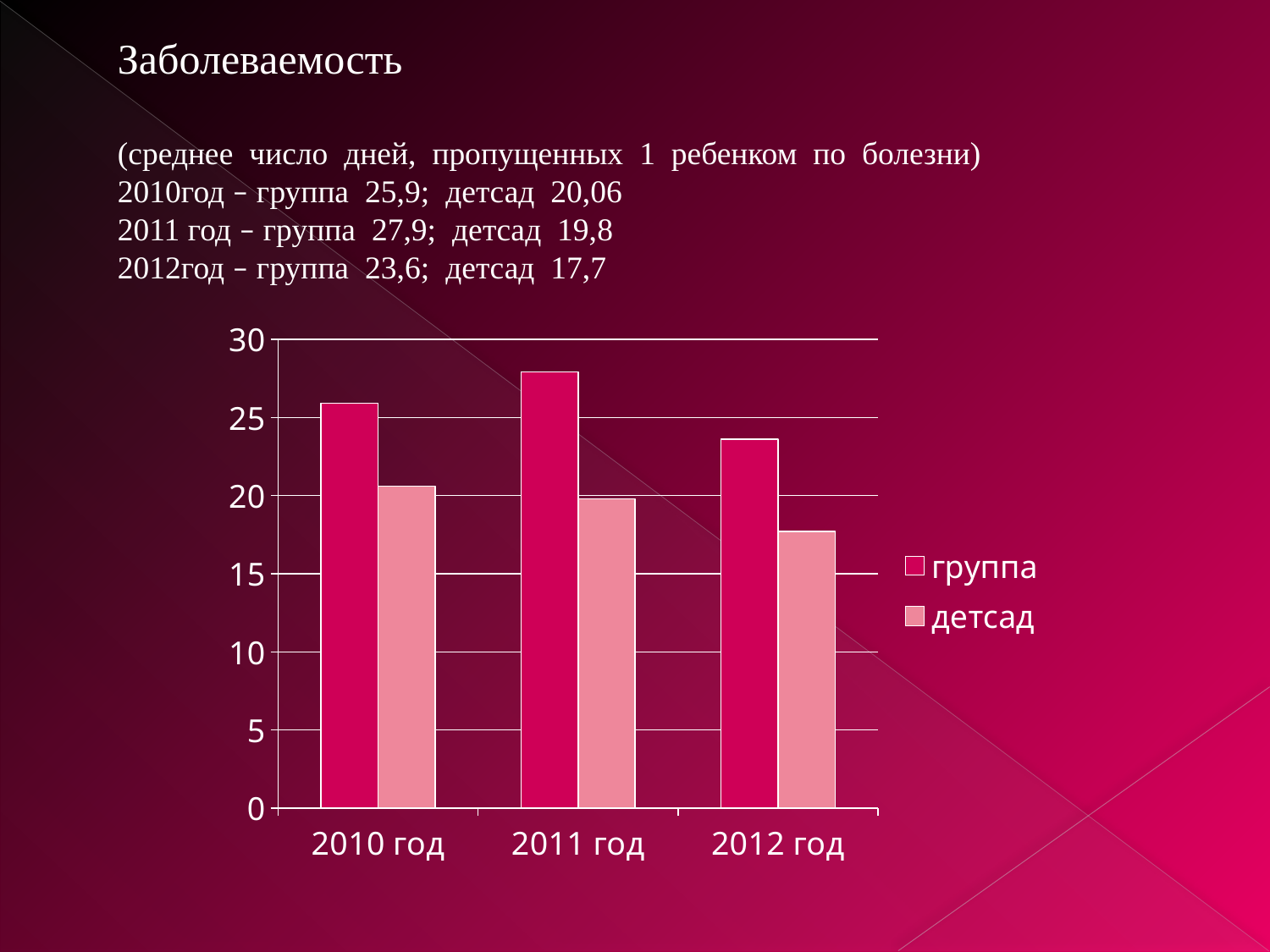
What kind of chart is shown on the slide? bar chart What is the difference between группа and детсад in 2011 год? 8,1 What is the value for детсад in 2012 год? 17,7 How many series does the chart legend list? 2 In which year is the группа value highest? 2011 год What is the value for группа in 2011 год? 27,9 Which is larger in 2012 год, группа or детсад? группа Is the value for группа in 2010 год greater or less than 25? greater Does the детсад value rise or fall from 2010 год to 2012 год? fall How many year categories are shown on the x axis of the chart? 3 In which year is the детсад value lowest? 2012 год